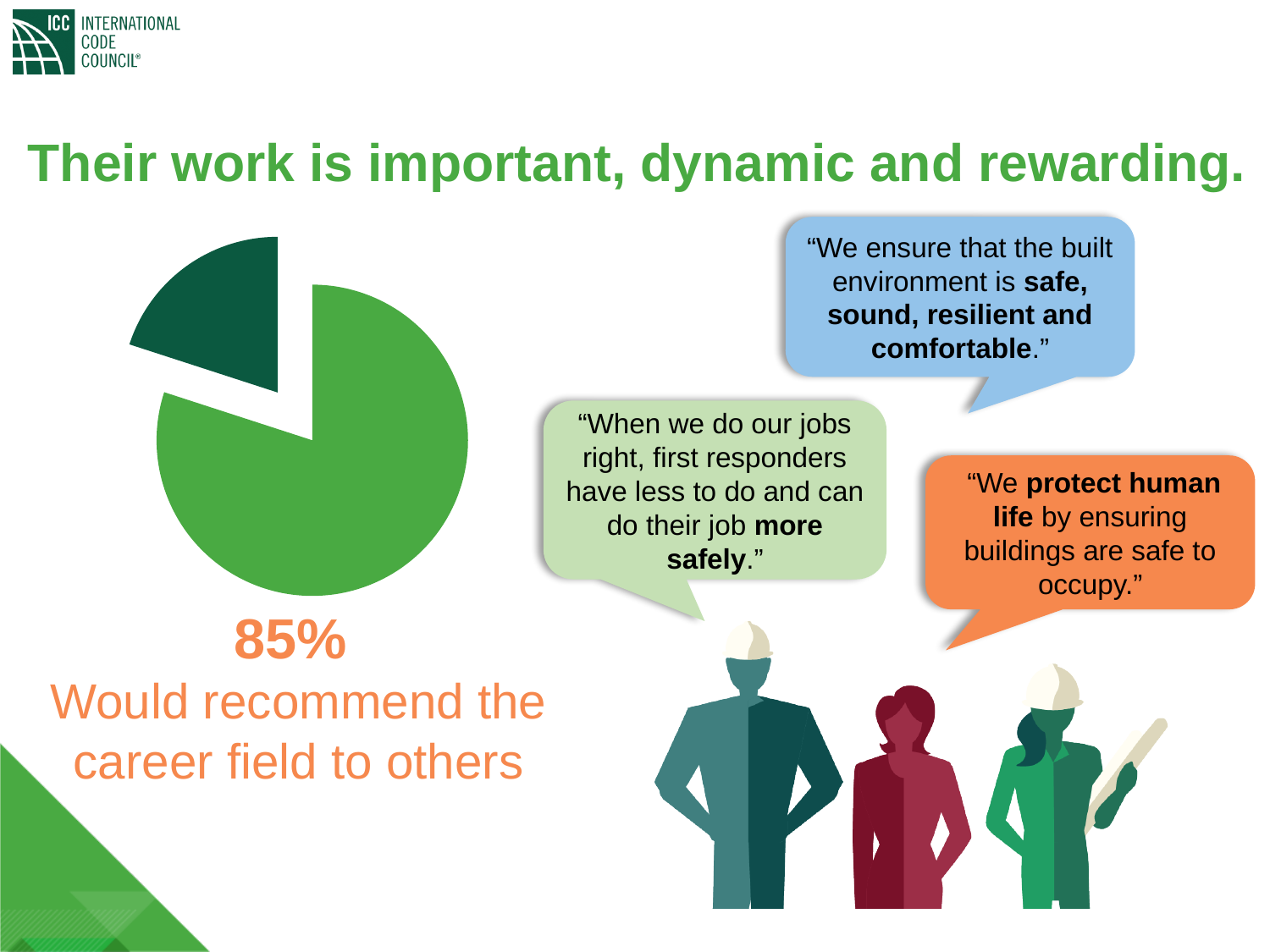
What does the 85% figure under the pie chart represent? Would recommend the career field to others Is the share of the small dark green slice greater or less than 25%? less What percentage is printed beneath the pie chart? 85% Is the share of the large light green slice greater or less than 50%? greater How many slices does the pie chart have? 2 What colour is the smaller, separated slice of the pie chart? dark green What kind of chart is shown on the slide? pie chart Which slice of the pie chart is larger, the light green one or the dark green one? the light green one